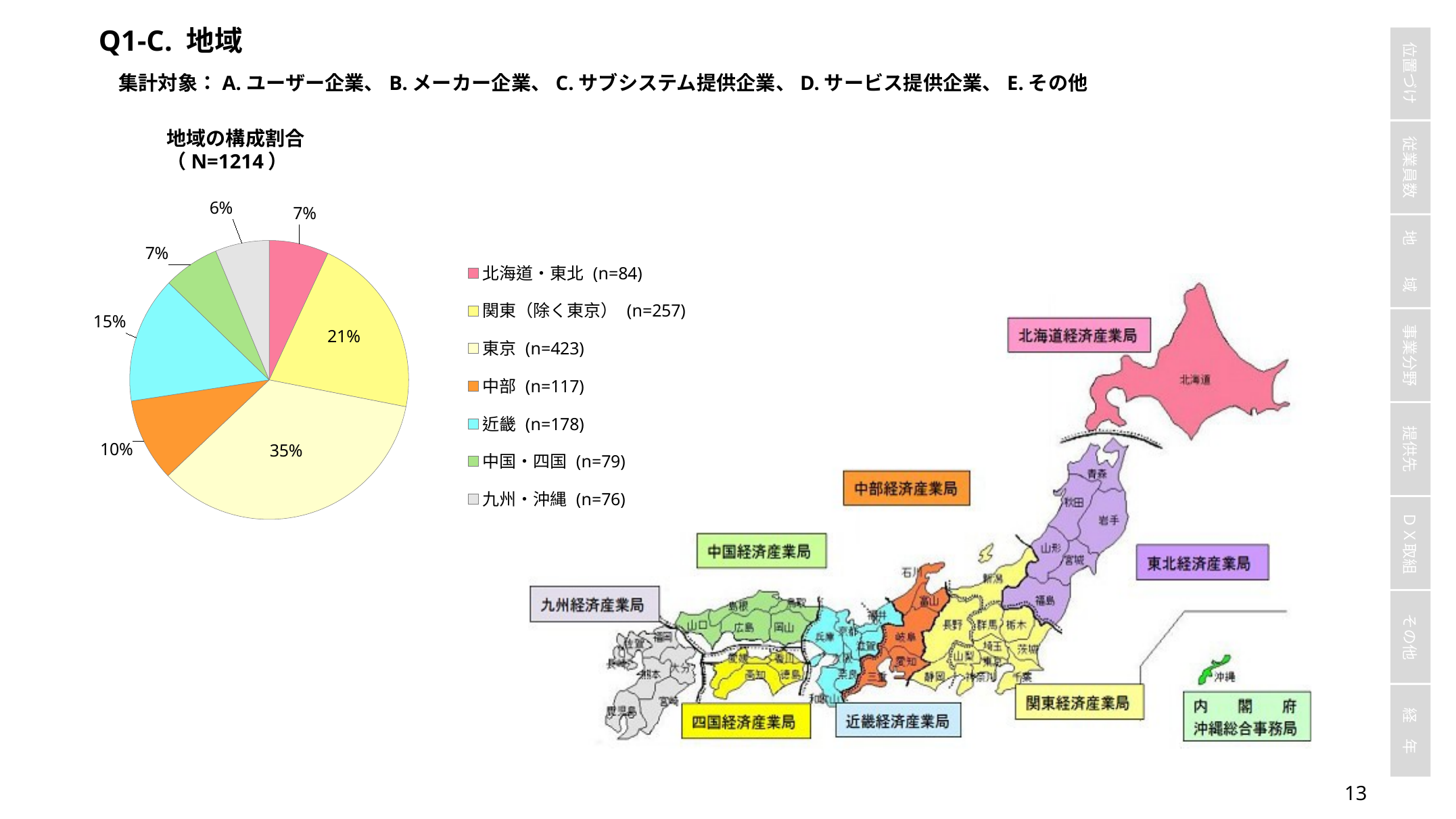
What percentage share does 東京 have in the pie chart? 35% Which region has the largest share in the pie chart? 東京 What is the difference in percentage points between the shares of 東京 and 関東（除く東京）? 14 How many regions (slices) does the pie chart show? 7 What is the total N shown in the pie chart title? N=1214 What percentage share does 近畿 have in the pie chart? 15% What percentage share does 中部 have in the pie chart? 10% What percentage share does 九州・沖縄 have in the pie chart? 6% Which region has the smallest share in the pie chart? 九州・沖縄 What kind of chart is shown on the slide? pie chart Which has a larger share in the pie chart, 近畿 or 中部? 近畿 What percentage share does 関東（除く東京） have in the pie chart? 21%